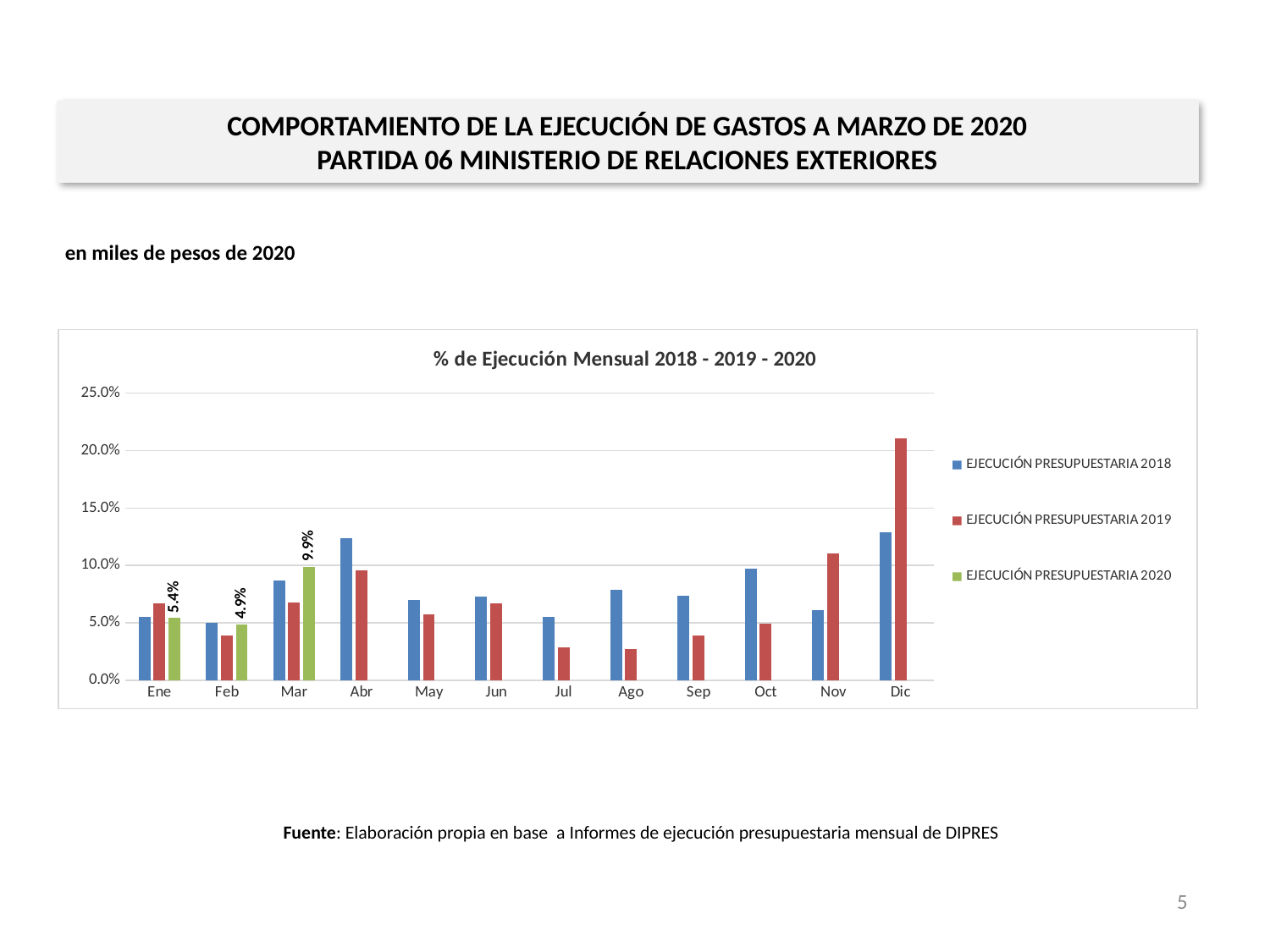
In Dic, which series has the larger value, EJECUCIÓN PRESUPUESTARIA 2018 or EJECUCIÓN PRESUPUESTARIA 2019? EJECUCIÓN PRESUPUESTARIA 2019 What is the difference between the EJECUCIÓN PRESUPUESTARIA 2020 values for Mar and Ene? 4.5% Is the value for EJECUCIÓN PRESUPUESTARIA 2019 in Dic greater or less than 20.0%? greater What is the value for EJECUCIÓN PRESUPUESTARIA 2020 in Mar? 9.9% What is the value for EJECUCIÓN PRESUPUESTARIA 2020 in Feb? 4.9% Which month has the lowest value for EJECUCIÓN PRESUPUESTARIA 2020? Feb Which month has the highest value for EJECUCIÓN PRESUPUESTARIA 2020? Mar How many months are shown on the x axis of the chart? 12 How many series does the chart legend list? 3 Is the value for EJECUCIÓN PRESUPUESTARIA 2018 in Abr greater or less than 10.0%? greater What is the value for EJECUCIÓN PRESUPUESTARIA 2020 in Ene? 5.4% What kind of chart is shown on the slide? Bar chart